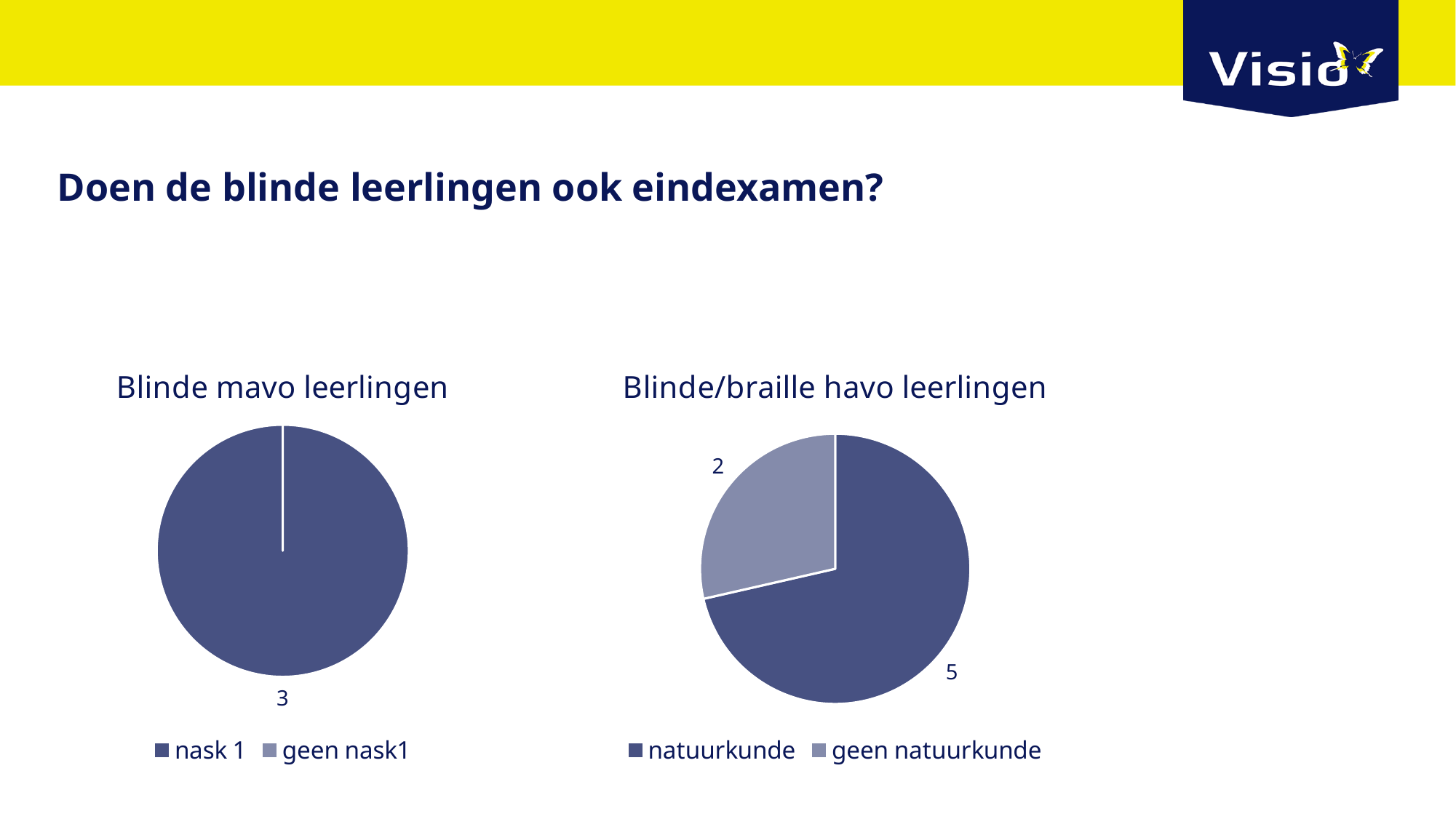
In the 'Blinde/braille havo leerlingen' chart, what is the difference between natuurkunde and geen natuurkunde? 3 In the 'Blinde/braille havo leerlingen' chart, which category has the largest slice? natuurkunde In the 'Blinde mavo leerlingen' chart, what is the value for nask 1? 3 What kind of chart is the 'Blinde mavo leerlingen' chart? pie chart In the 'Blinde/braille havo leerlingen' chart, which is larger: natuurkunde or geen natuurkunde? natuurkunde In the 'Blinde/braille havo leerlingen' chart, which category has the smallest slice? geen natuurkunde In the 'Blinde mavo leerlingen' chart, which category fills the entire pie? nask 1 In the 'Blinde/braille havo leerlingen' chart, what is the total of natuurkunde and geen natuurkunde? 7 What is the title of the left chart on the slide? Blinde mavo leerlingen In the 'Blinde/braille havo leerlingen' chart, what is the value for natuurkunde? 5 In the 'Blinde/braille havo leerlingen' chart, what is the value for geen natuurkunde? 2 How many entries does the legend of the 'Blinde/braille havo leerlingen' chart list? 2